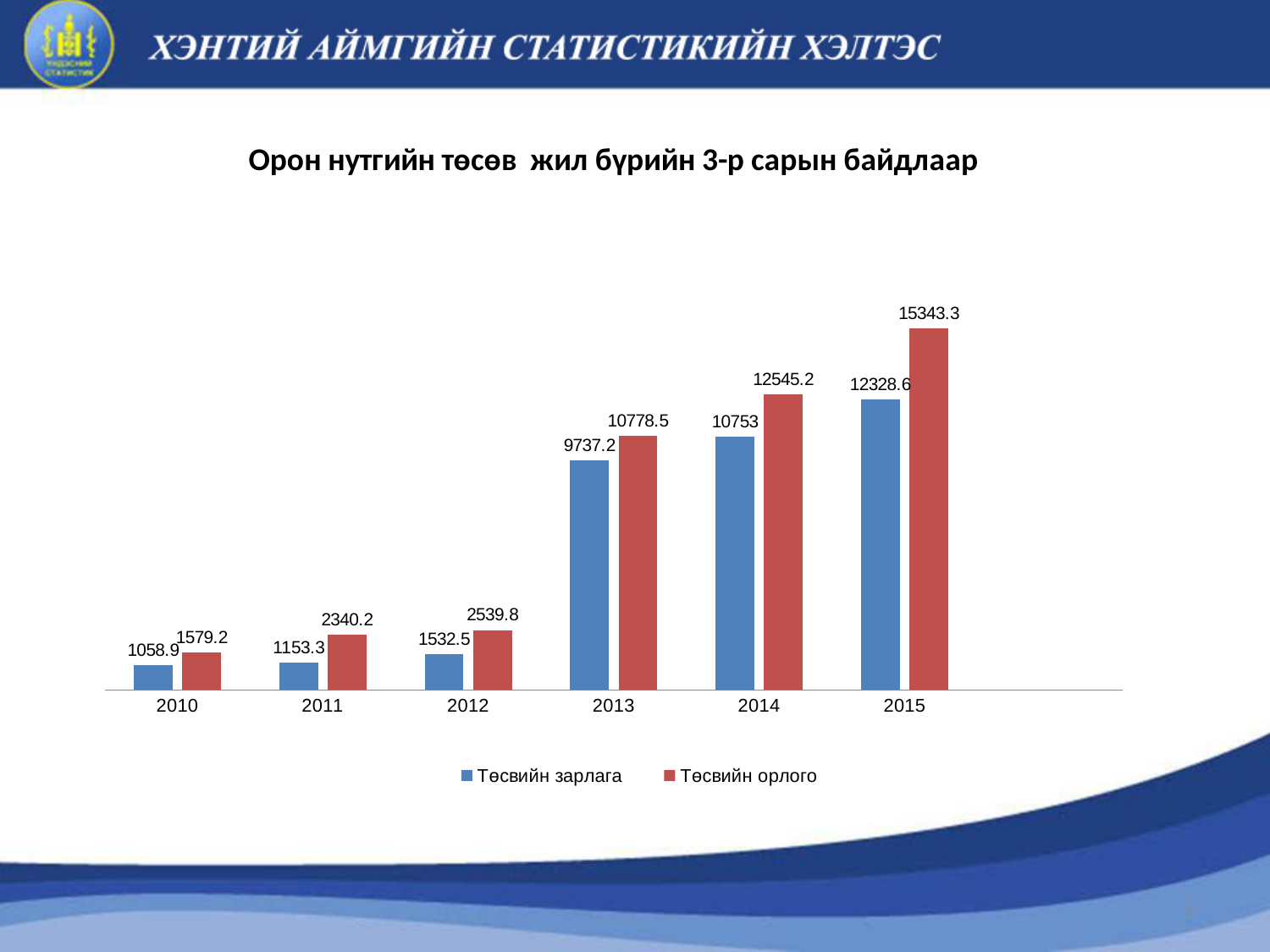
What is the value of Төсвийн орлого for 2011? 2340.2 What is the value of Төсвийн зарлага for 2014? 10753 What is the value of Төсвийн зарлага for 2013? 9737.2 Which year has the highest value for Төсвийн орлого? 2015 Which year has the lowest value for Төсвийн зарлага? 2010 How many series does the legend list? 2 What is the value of Төсвийн орлого for 2015? 15343.3 What is the difference between Төсвийн орлого in 2014 and Төсвийн орлого in 2013? 1766.7 How many years are shown on the x axis? 6 What kind of chart is shown on the slide? Bar chart What is the difference between Төсвийн орлого and Төсвийн зарлага in 2015? 3014.7 Which is larger in 2012, Төсвийн зарлага or Төсвийн орлого? Төсвийн орлого